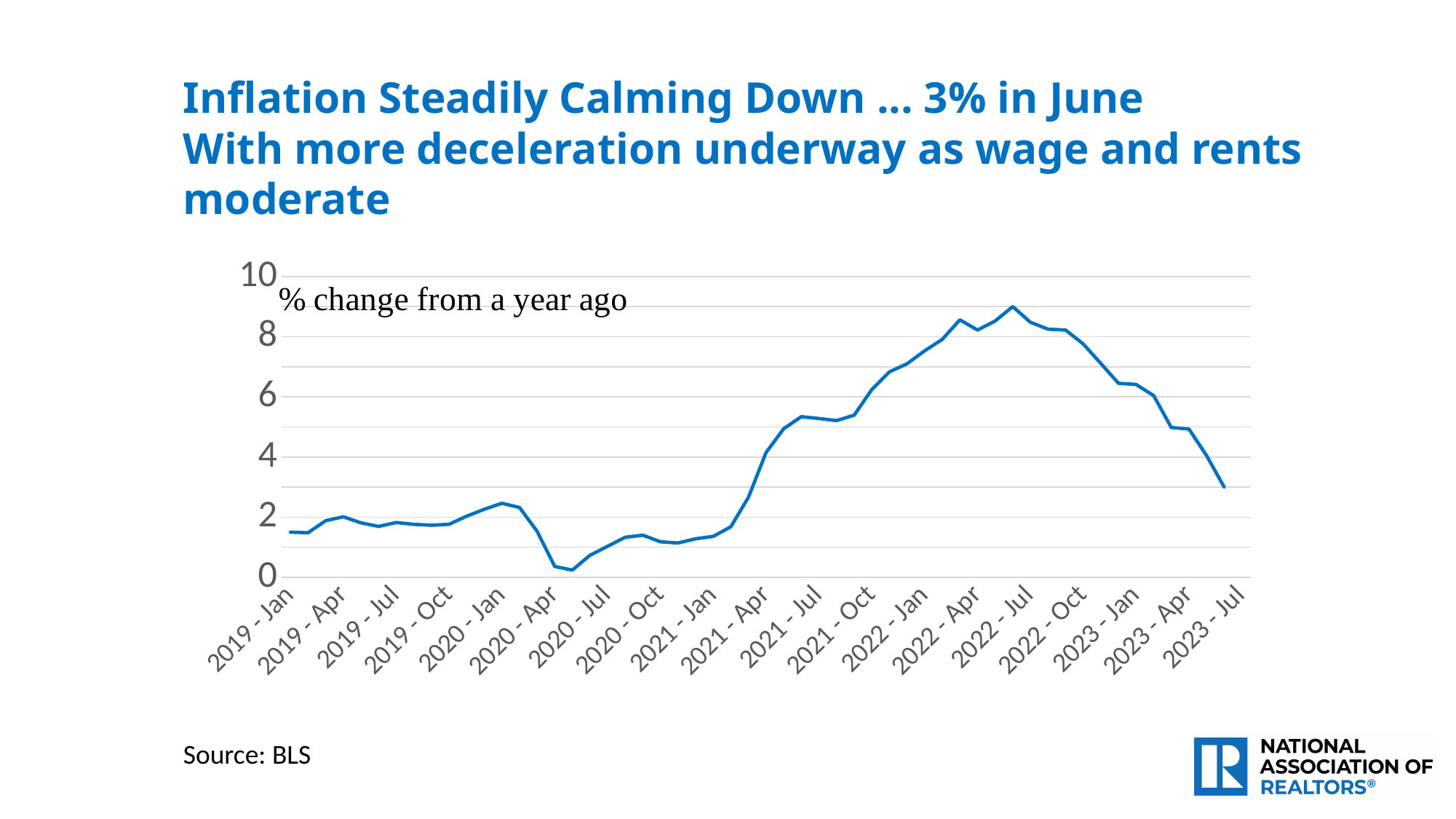
Which is larger, the value for 2022 - Jul or the value for 2019 - Jul? 2022 - Jul In which year does the line reach its highest value? 2022 Is the value for 2021 - Jan greater or less than 2? less Does the line rise or fall between 2022 - Jul and 2023 - Jul? fall How many labels are shown on the x axis? 19 Is the value for 2022 - Jul greater or less than 8? greater Is the value for 2020 - Apr greater or less than 2? less According to the slide title, what was the inflation rate in June? 3% What is the source cited at the bottom of the slide? BLS What kind of chart is shown on the slide? line chart In which year does the line reach its lowest value? 2020